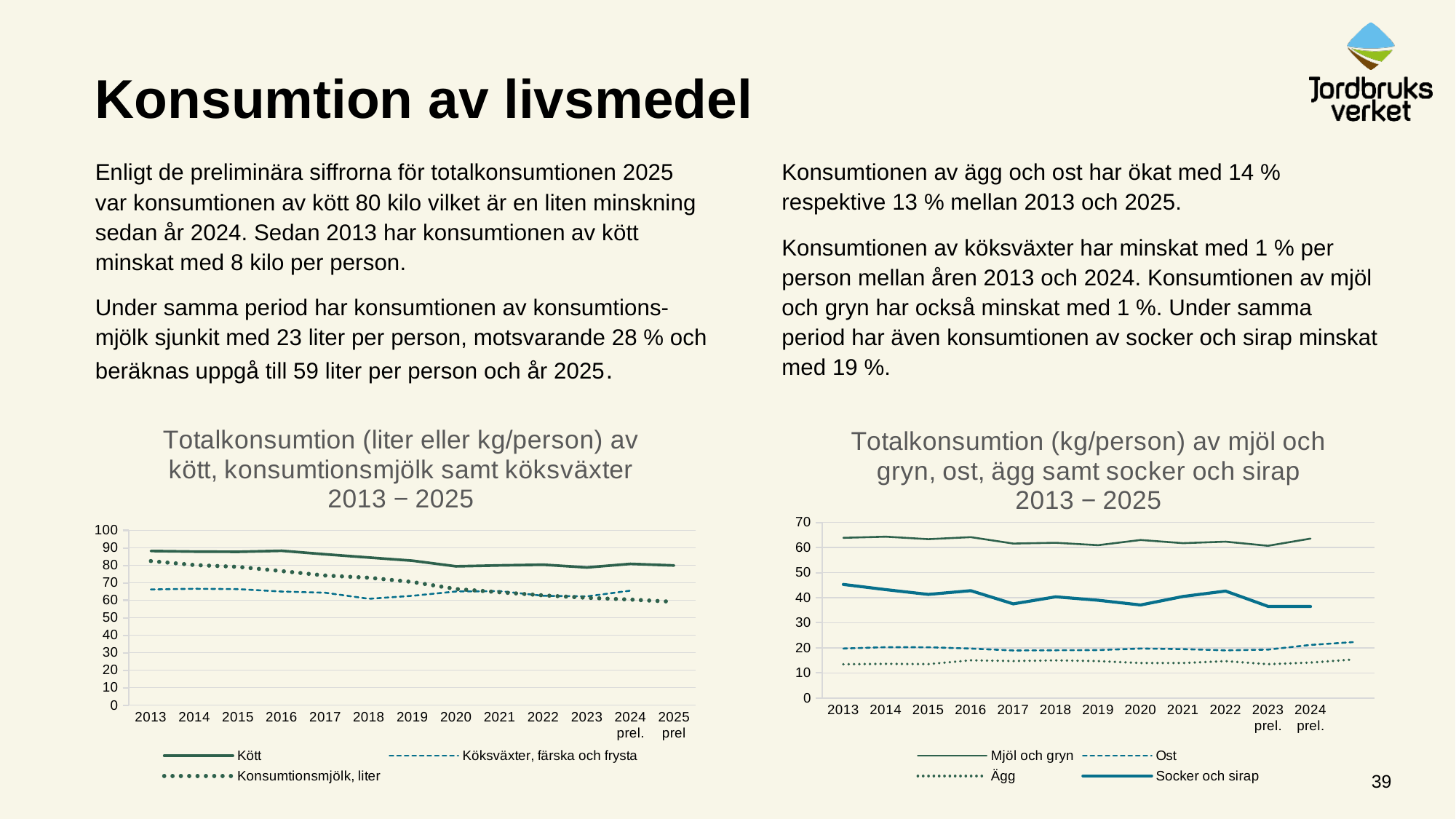
In the right chart, which series has the lowest values across all years? Ägg How many series does the legend of the right chart, 'Totalkonsumtion (kg/person) av mjöl och gryn, ost, ägg samt socker och sirap 2013 − 2025', list? 4 In the right chart, is the value for Ägg in 2013 greater or less than 20? less In the left chart, is the value for Kött in 2013 greater or less than 80? greater In the left chart, does the Konsumtionsmjölk, liter series rise or fall from 2013 to 2025? Fall In the right chart, is the value for Socker och sirap in 2013 greater or less than 40? greater How many series does the legend of the left chart list? 3 What kind of chart is the left chart, 'Totalkonsumtion (liter eller kg/person) av kött, konsumtionsmjölk samt köksväxter 2013 − 2025'? Line chart In the right chart, which series has the highest values across all years? Mjöl och gryn How many years are shown on the x axis of the left chart? 13 How many years are shown on the x axis of the right chart? 12